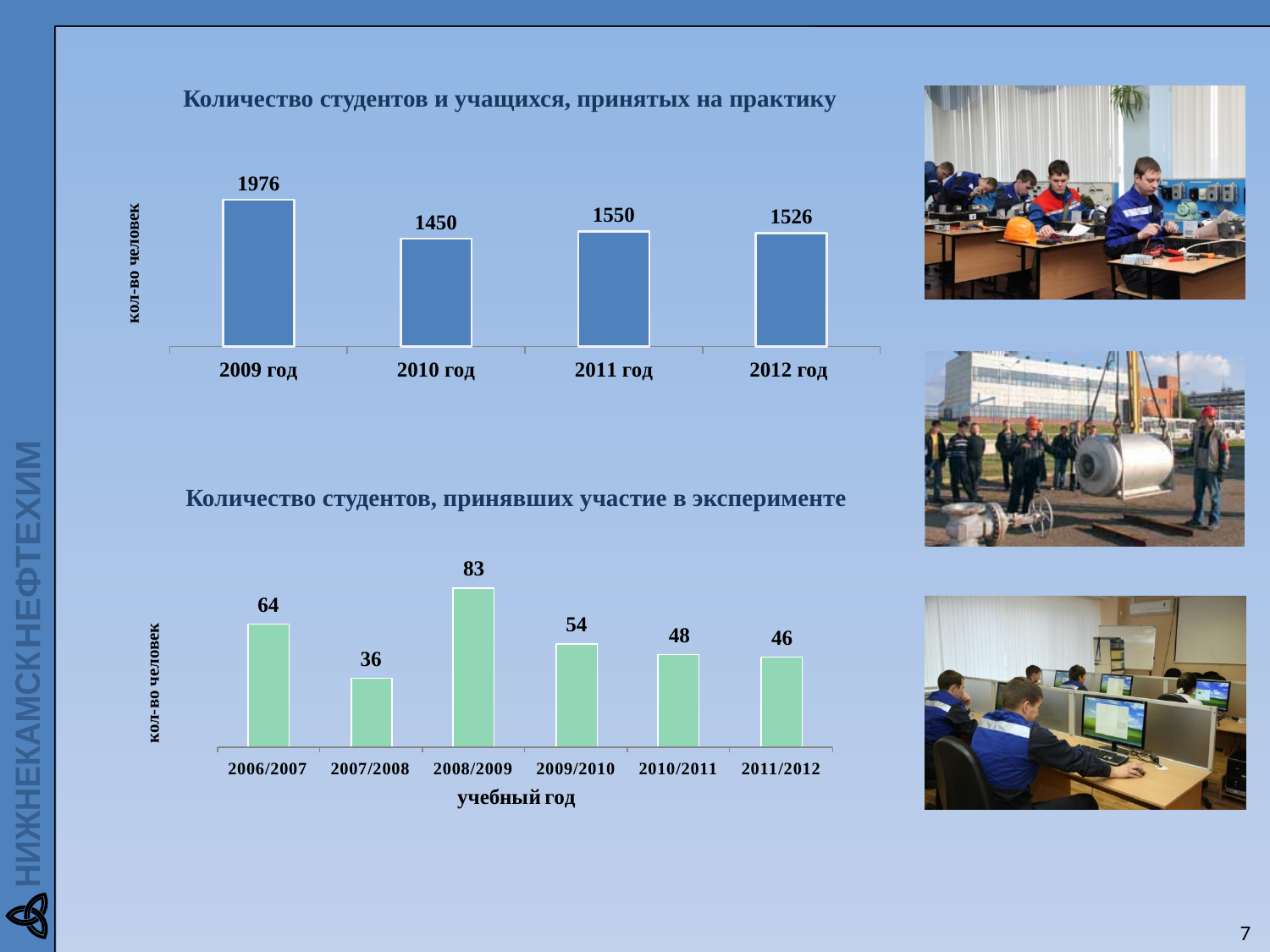
In the top chart 'Количество студентов и учащихся, принятых на практику', which year has the lowest value? 2010 год In the top chart 'Количество студентов и учащихся, принятых на практику', what is the value for 2009 год? 1976 In the bottom chart 'Количество студентов, принявших участие в эксперименте', what is the value for 2008/2009? 83 In the bottom chart 'Количество студентов, принявших участие в эксперименте', which academic year has the lowest value? 2007/2008 In the top chart 'Количество студентов и учащихся, принятых на практику', how many years are shown? 4 What kind of chart is the bottom chart 'Количество студентов, принявших участие в эксперименте'? bar chart In the bottom chart 'Количество студентов, принявших участие в эксперименте', what is the difference between the values for 2006/2007 and 2007/2008? 28 In the bottom chart 'Количество студентов, принявших участие в эксперименте', do the values rise or fall from 2008/2009 to 2011/2012? fall In the bottom chart 'Количество студентов, принявших участие в эксперименте', how many academic years are shown? 6 In the bottom chart 'Количество студентов, принявших участие в эксперименте', which academic year has the highest value? 2008/2009 In the top chart 'Количество студентов и учащихся, принятых на практику', what is the difference between the values for 2009 год and 2010 год? 526 In the top chart 'Количество студентов и учащихся, принятых на практику', which is larger, the value for 2011 год or 2012 год? 2011 год